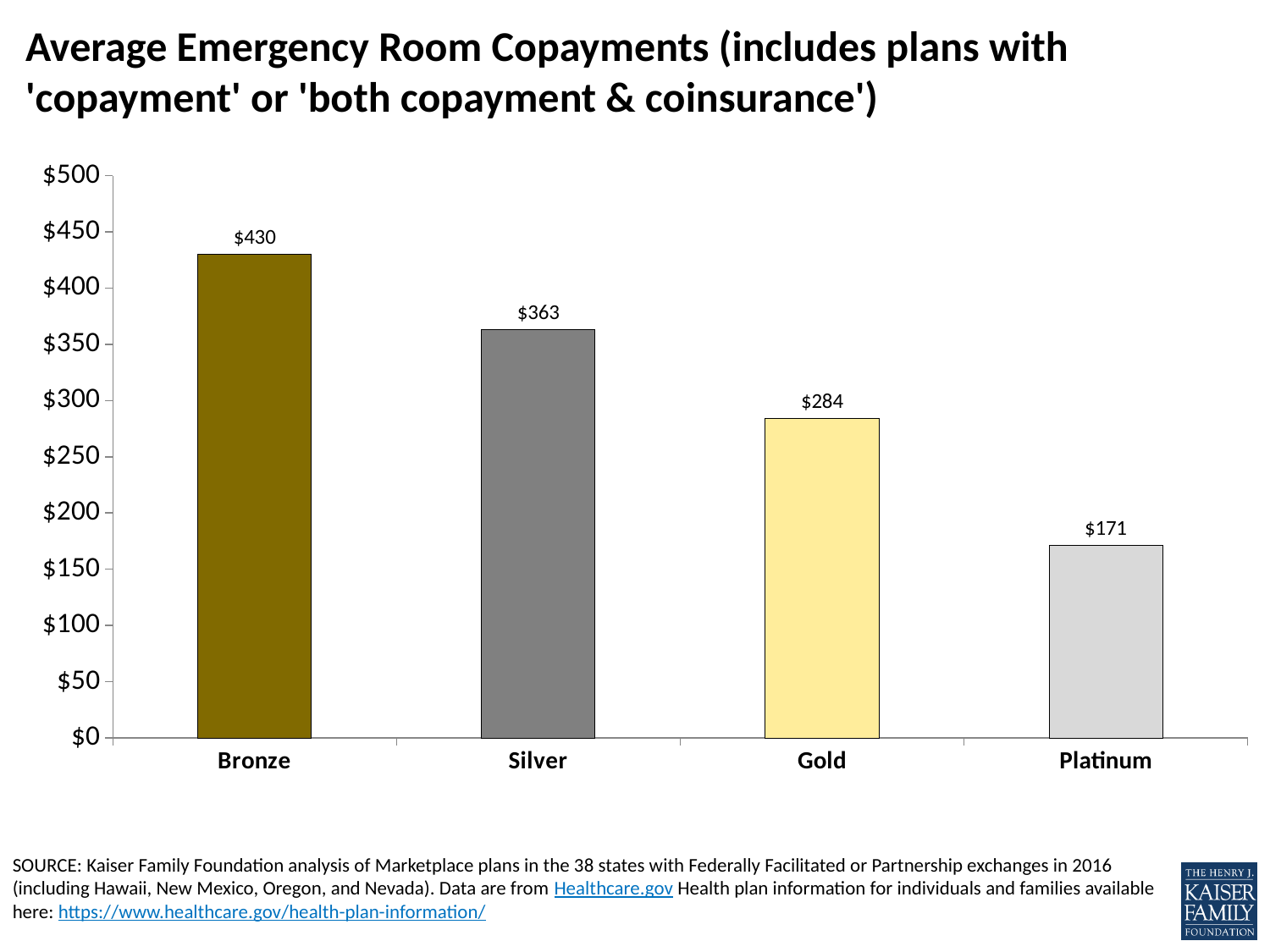
What is the difference between the Silver and Gold average emergency room copayments? $79 What is the average emergency room copayment for Gold plans? $284 What is the difference between the Bronze and Platinum average emergency room copayments? $259 Which plan type has the lowest average emergency room copayment? Platinum What kind of chart is shown on the slide? Bar chart Which is larger, the average emergency room copayment for Silver or for Gold? Silver What is the average emergency room copayment for Bronze plans? $430 How many plan types are shown on the chart? 4 Do the average emergency room copayments rise or fall moving from Bronze to Platinum? Fall Which plan type has the highest average emergency room copayment? Bronze What is the average emergency room copayment for Platinum plans? $171 What is the average emergency room copayment for Silver plans? $363